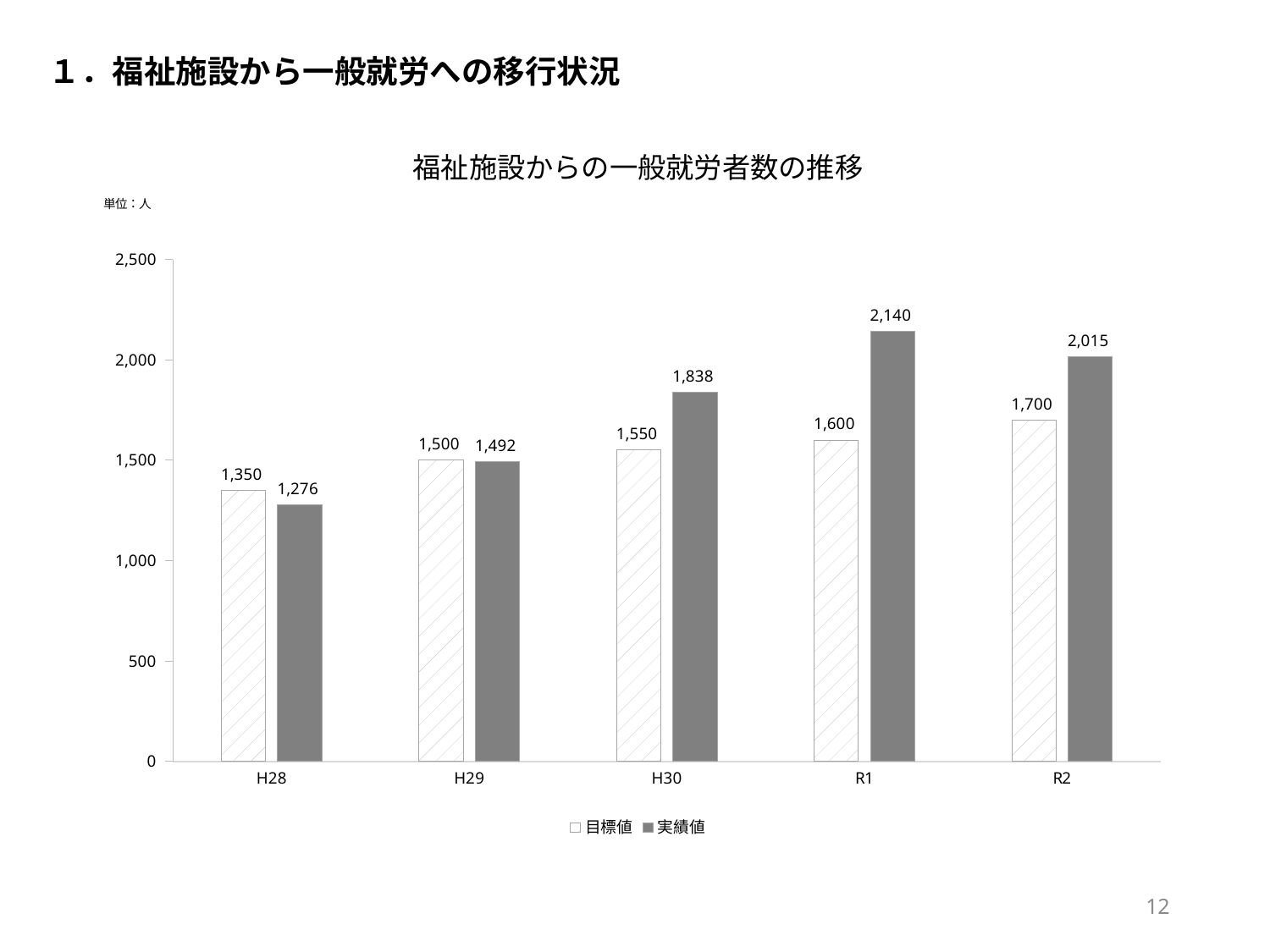
What is the 実績値 for H28? 1,276 Does the 目標値 rise or fall from H28 to R2? rise Which year has the highest 実績値? R1 How many years are shown on the x axis? 5 What is the difference between the 実績値 and the 目標値 for R2? 315 How many series does the legend list? 2 What is the 目標値 (target value) for H30? 1,550 Which year has the lowest 目標値? H28 Which is larger for H29, the 目標値 or the 実績値? 目標値 What is the 実績値 (actual value) for R1? 2,140 What kind of chart is shown on the slide? bar chart Is the 実績値 for H30 greater or less than 2,000? less